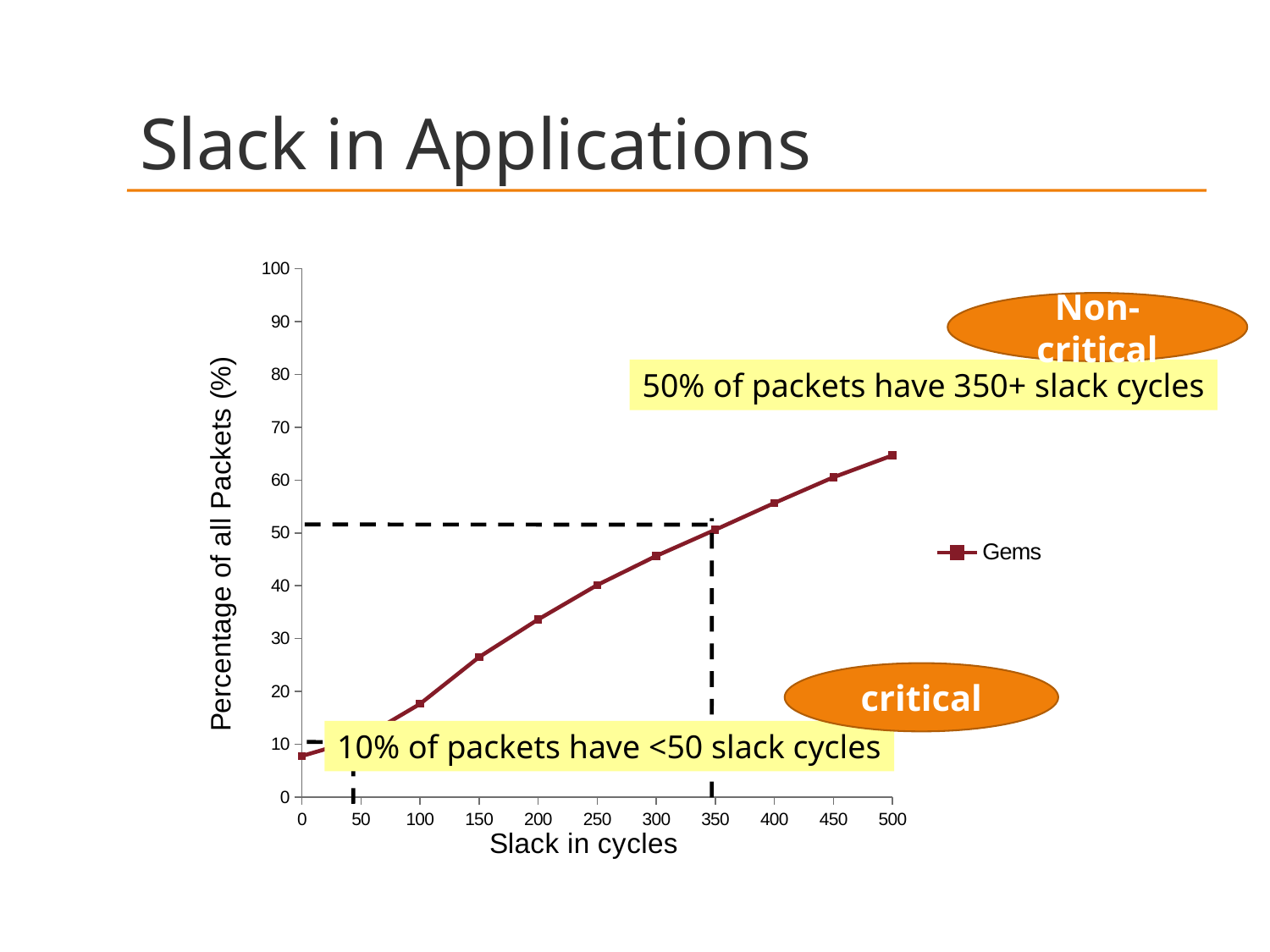
What is the name of the series shown in the legend? Gems Is the value for Gems at 500 slack cycles greater or less than 60? greater Do the values of the Gems series rise or fall as slack in cycles increases? rise Is the value for Gems at 300 slack cycles greater or less than 50? less At which slack value is the Gems series lowest? 0 What is the title of the x axis? Slack in cycles Is the value for Gems at 150 slack cycles greater or less than 30? less What kind of chart is shown on the slide? line chart Which is larger for Gems: the value at 400 slack cycles or the value at 250 slack cycles? 400 slack cycles How many series does the legend list? 1 At which slack value is the Gems series highest? 500